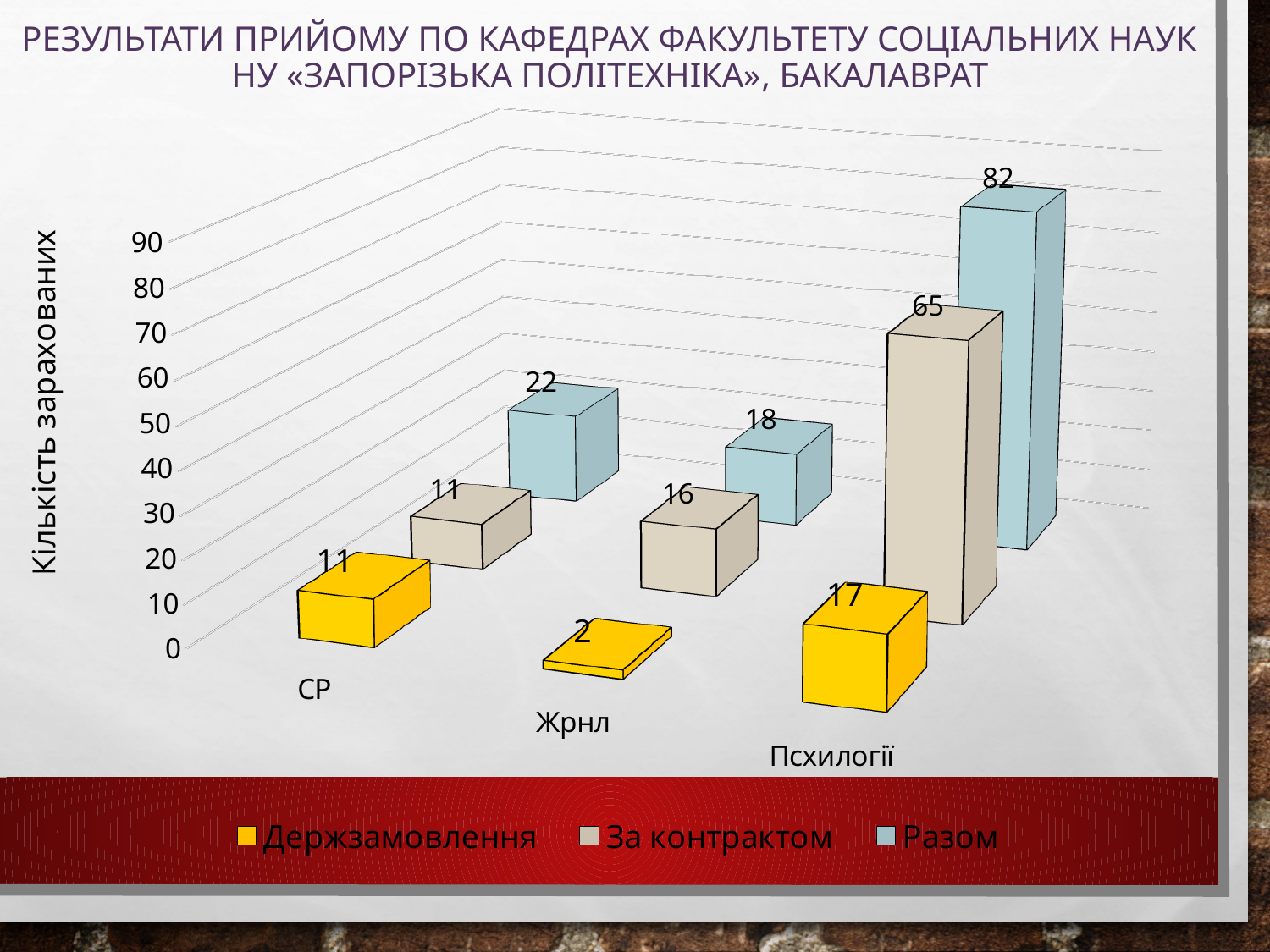
What is the value of Разом for Псхилогії? 82 What kind of chart is shown on the slide? Bar chart What is the value of За контрактом for СР? 11 How many series does the legend list? 3 Which category has the highest Разом value? Псхилогії What is the difference between За контрактом for Псхилогії and За контрактом for Жрнл? 49 Which is larger: Разом for СР or Разом for Жрнл? Разом for СР What is the label of the vertical axis? Кількість зарахованих Is the value of За контрактом for Псхилогії greater or less than 60? greater Which category has the lowest Держзамовлення value? Жрнл How many categories are shown on the x axis? 3 What is the value of Держзамовлення for Жрнл? 2